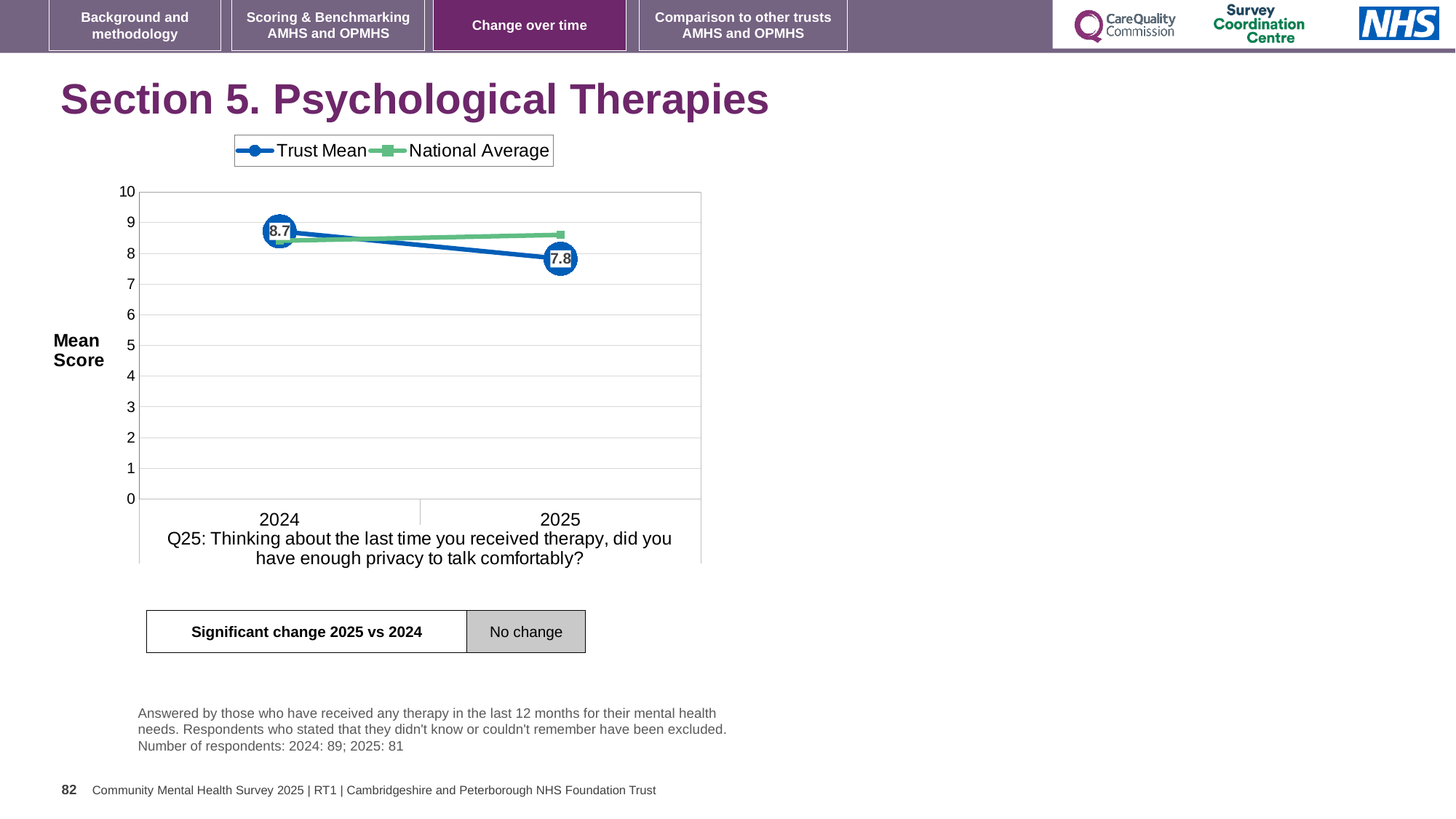
What is the label on the y axis of the chart? Mean Score What kind of chart is shown on the slide? line chart How many series does the legend list? 2 Is the Trust Mean value for 2025 greater or less than 8? less What is the Trust Mean score for 2025? 7.8 In 2025, which is higher: the Trust Mean or the National Average? National Average In which year is the Trust Mean score higher? 2024 Does the Trust Mean rise or fall from 2024 to 2025? fall Is the National Average value for 2025 greater or less than 8? greater By how much did the Trust Mean score change from 2024 to 2025? 0.9 How many years are plotted on the x axis? 2 What is the Trust Mean score for 2024? 8.7